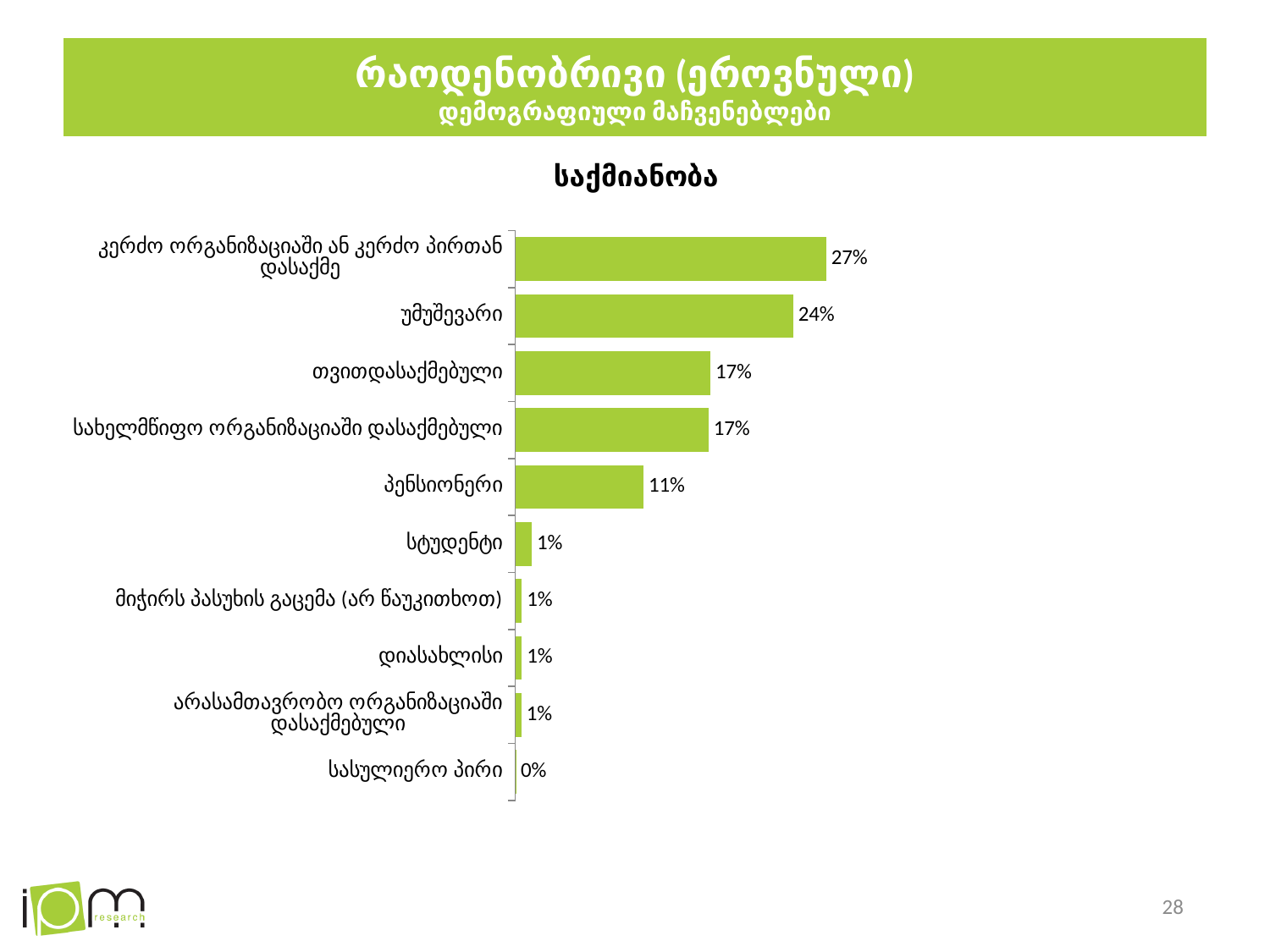
What type of chart is shown on the slide? bar chart What is the value for უმუშევარი? 24% What is the difference between the values for სახელმწიფო ორგანიზაციაში დასაქმებული and პენსიონერი? 6% What is the title of the chart? საქმიანობა Which category has the lowest value? სასულიერო პირი How many categories are shown in the chart? 10 Which is larger, the value for უმუშევარი or the value for პენსიონერი? უმუშევარი Which category has the highest value? კერძო ორგანიზაციაში ან კერძო პირთან დასაქმე What is the value for თვითდასაქმებული? 17% What is the value for პენსიონერი? 11% What is the difference between the values for კერძო ორგანიზაციაში ან კერძო პირთან დასაქმე and უმუშევარი? 3% What is the value for სასულიერო პირი? 0%